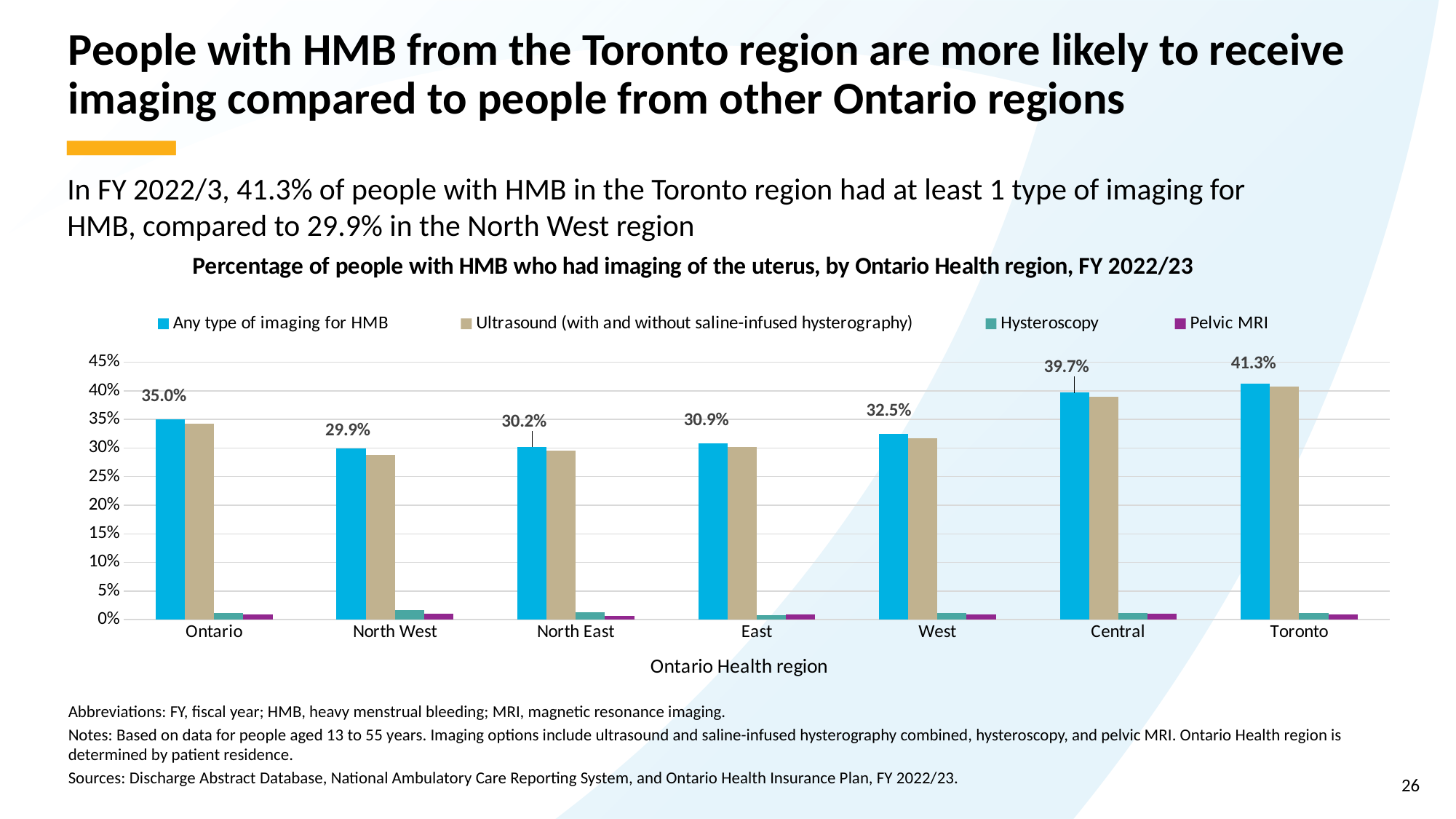
Is the Ultrasound value for the Toronto region greater or less than 35%? greater Which region has the highest value for 'Any type of imaging for HMB'? Toronto Is the Hysteroscopy value for the North West region greater or less than 5%? less How many series does the legend list? 4 What kind of chart is shown on the slide? Bar chart Which has a higher value for 'Any type of imaging for HMB': East or West? West How many Ontario Health regions are shown on the x axis? 7 What percentage of people with HMB in the Toronto region had any type of imaging for HMB? 41.3% Which region has the lowest value for 'Any type of imaging for HMB'? North West What is the value for 'Any type of imaging for HMB' in the Central region? 39.7% What is the value for 'Any type of imaging for HMB' in the North West region? 29.9% What is the difference between the 'Any type of imaging for HMB' values for Toronto and North West? 11.4%